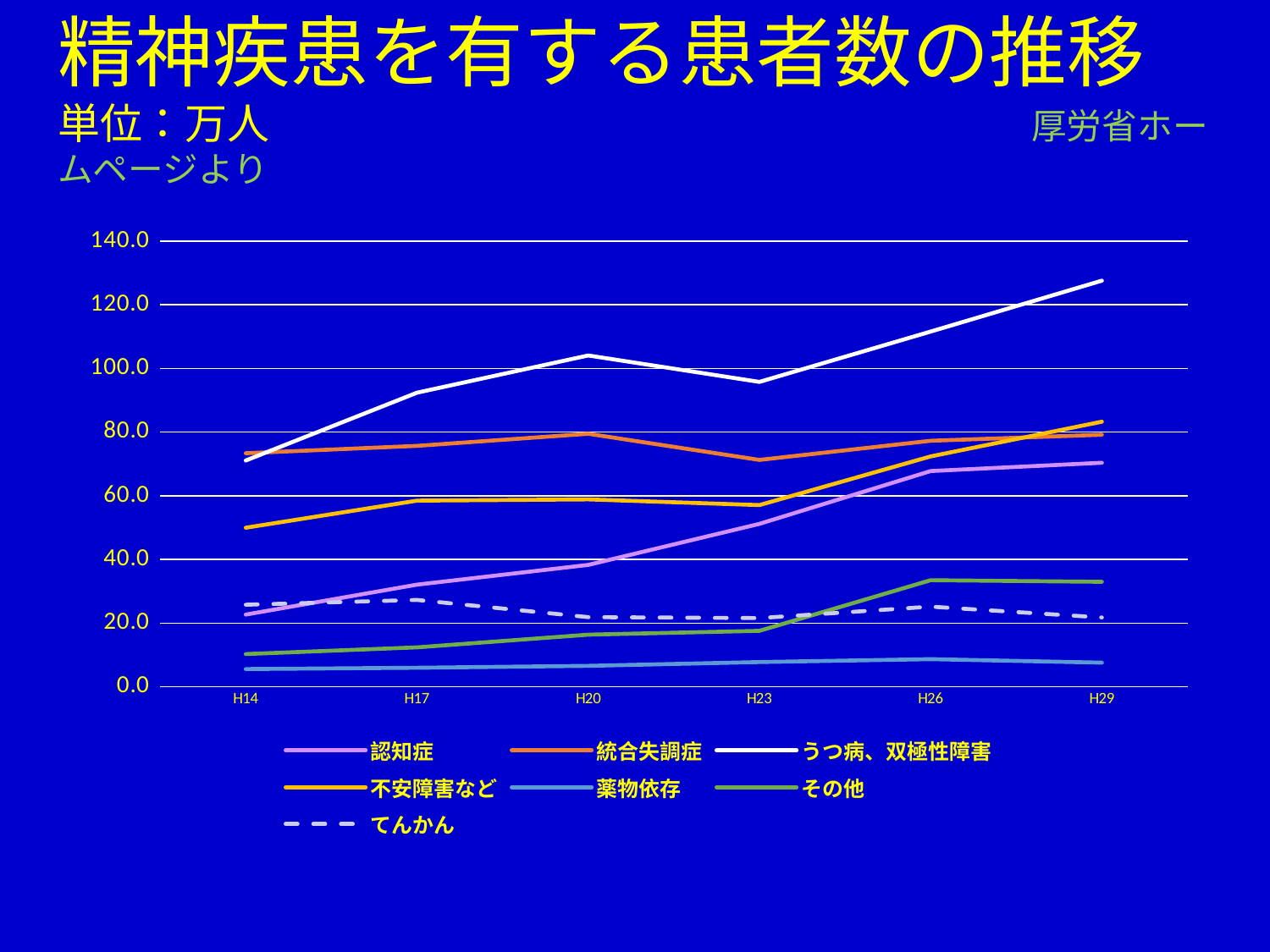
Is the value for 不安障害など at H14 greater or less than 60.0? less Is the value for 認知症 at H29 greater or less than 60.0? greater Is the value for 薬物依存 at H29 greater or less than 20.0? less How many points are there along the x axis? 6 Which series has the lowest value at H29? 薬物依存 Which series has the highest value at H29? うつ病、双極性障害 Which series is drawn with a dashed line? てんかん How many series does the legend list? 7 What kind of chart is shown on the slide? line chart At H14, which is larger: 統合失調症 or 認知症? 統合失調症 Does the value for 認知症 rise or fall from H14 to H29? rise